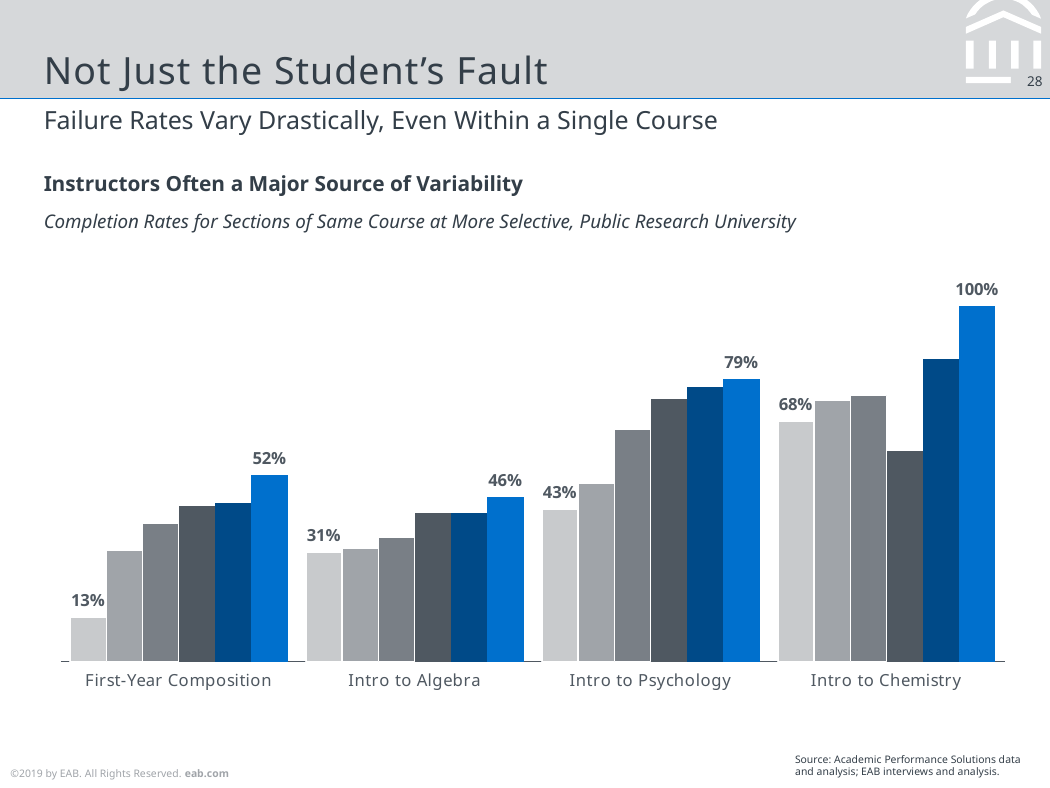
How many bars (sections) are shown for each course? 6 What is the lowest labeled completion rate shown for Intro to Algebra? 31% What is the highest labeled completion rate shown for Intro to Chemistry? 100% What kind of chart is shown on the slide? Bar chart How many courses are shown on the x axis of the chart? 4 What is the difference between the highest and lowest labeled completion rates for First-Year Composition? 39 percentage points Which course has the lowest labeled completion rate on the chart? First-Year Composition Which is larger: the highest labeled completion rate for First-Year Composition or for Intro to Algebra? First-Year Composition What is the highest labeled completion rate shown for Intro to Psychology? 79% Which course has the highest labeled completion rate on the chart? Intro to Chemistry What is the lowest labeled completion rate shown for First-Year Composition? 13% What is the difference between the highest and lowest labeled completion rates for Intro to Chemistry? 32 percentage points